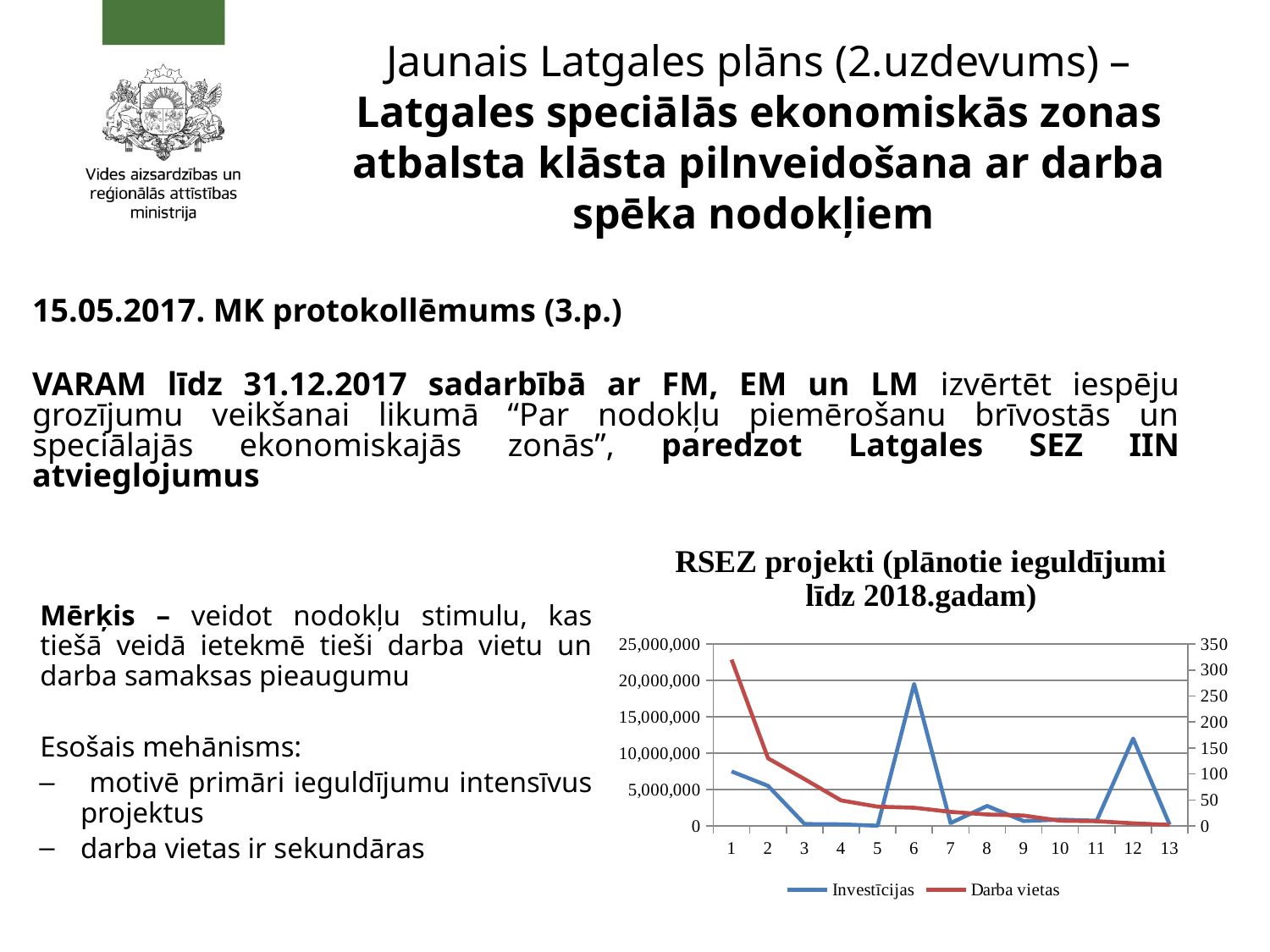
Is the Darba vietas value at point 2 greater or less than 100? greater At which x-axis point does the Investīcijas series reach its highest value? 6 How many series does the chart legend list? 2 At which x-axis point does the Darba vietas series reach its highest value? 1 Is the Investīcijas value at point 6 greater or less than 15,000,000? greater Does the Darba vietas series generally rise or fall from point 1 to point 13? fall How many points are plotted along the x axis of the chart? 13 Which is larger for the Investīcijas series: the value at point 6 or the value at point 12? point 6 At which x-axis point is the Darba vietas series lowest? 13 What kind of chart is shown on the slide? line chart Is the Investīcijas value at point 3 greater or less than 5,000,000? less